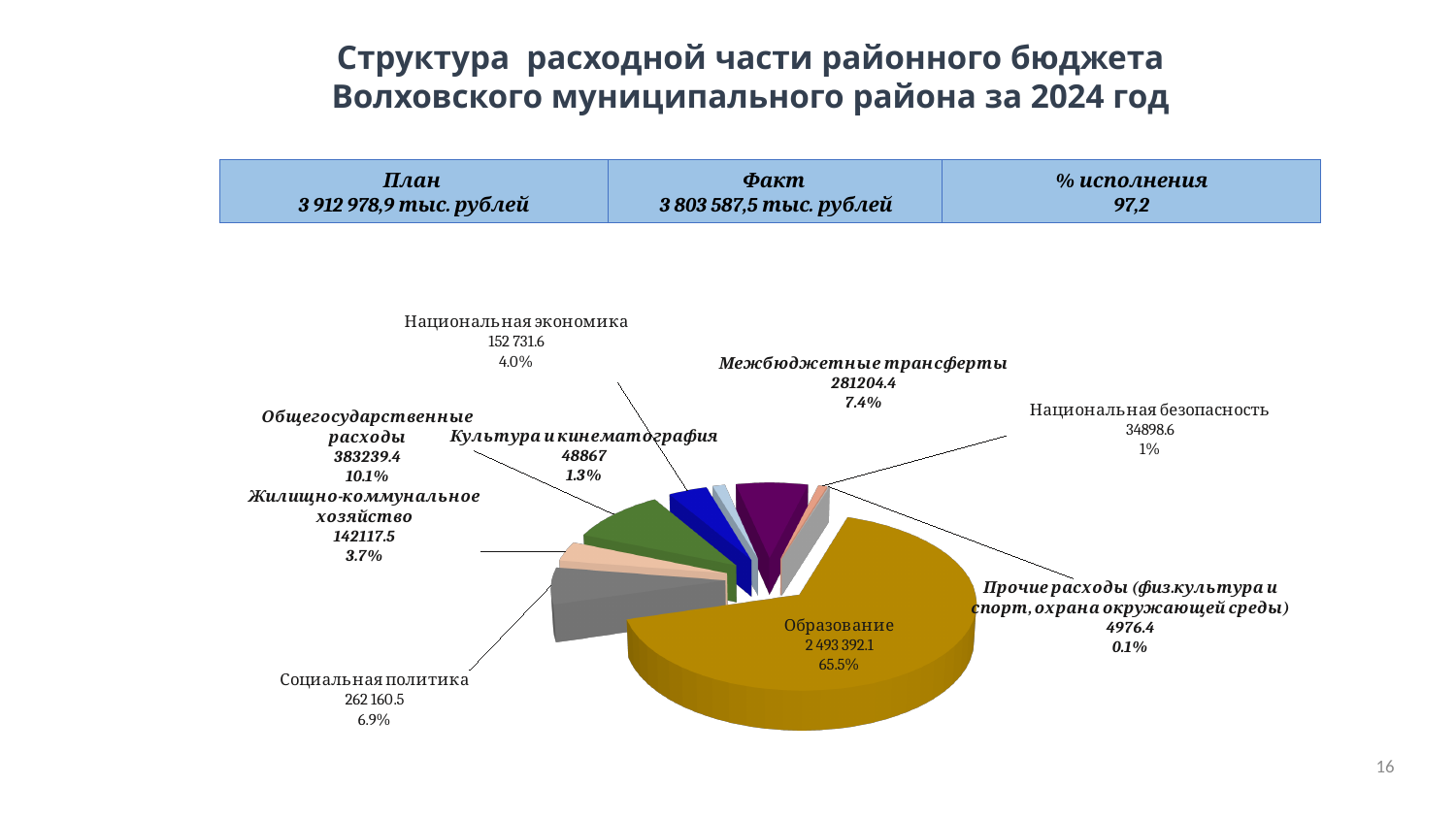
What is the value shown for Культура и кинематография? 48867 What is the difference in percentage share between Межбюджетные трансферты and Социальная политика? 0.5% Which is larger: Национальная экономика or Жилищно-коммунальное хозяйство? Национальная экономика Which category has the smallest slice of the pie chart? Прочие расходы (физ.культура и спорт, охрана окружающей среды) What share of the pie does Общегосударственные расходы account for? 10.1% What is the value shown for Межбюджетные трансферты? 281204.4 What is the percentage share shown for Национальная безопасность? 1% Which category has the largest slice of the pie chart? Образование What share of the pie does Образование account for? 65.5% What is the value shown for Социальная политика? 262 160.5 What kind of chart is shown on the slide? Pie chart How many categories (slices) does the pie chart show? 9